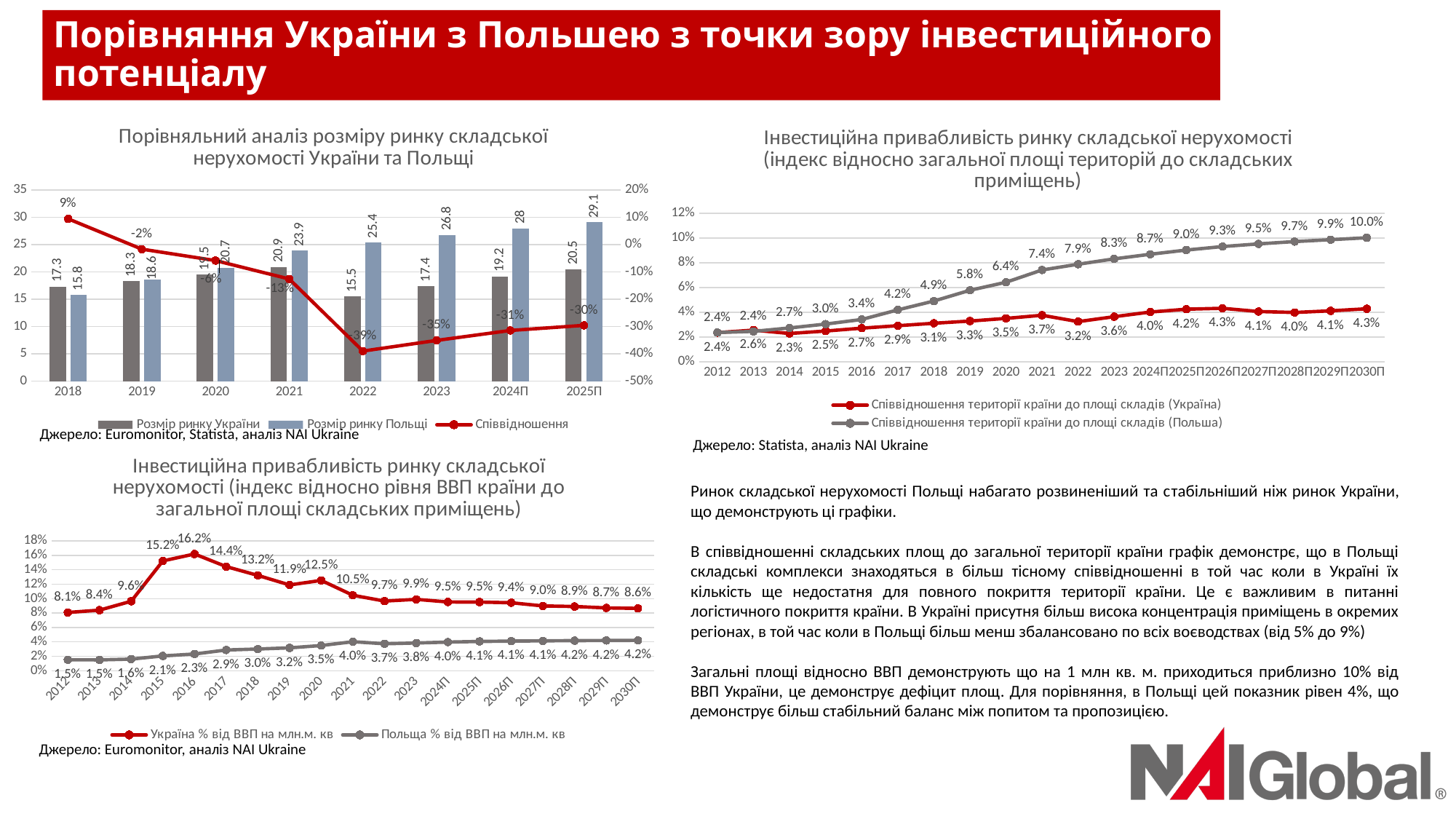
In the top-right chart (Інвестиційна привабливість ринку складської нерухомості, індекс відносно загальної площі територій), what is the value for Польша in 2030П? 10.0% What type of chart is the bottom-left chart (Інвестиційна привабливість ринку складської нерухомості, індекс відносно рівня ВВП)? line chart In the bottom-left chart (Інвестиційна привабливість ринку складської нерухомості, індекс відносно рівня ВВП), in which year is the Україна % від ВВП на млн.м. кв value the highest? 2016 In the top-left chart (Порівняльний аналіз розміру ринку складської нерухомості України та Польщі), what is the Співвідношення value for 2022? -39% In the bottom-left chart (Інвестиційна привабливість ринку складської нерухомості, індекс відносно рівня ВВП), what is the value for Польща % від ВВП на млн.м. кв in 2012? 1.5% In the top-left chart (Порівняльний аналіз розміру ринку складської нерухомості України та Польщі), in which year is Розмір ринку України the lowest? 2022 In the top-right chart (Інвестиційна привабливість ринку складської нерухомості, індекс відносно загальної площі територій), how many years are shown on the x axis? 19 In the top-left chart (Порівняльний аналіз розміру ринку складської нерухомості України та Польщі), how many series does the legend list? 3 In the top-left chart (Порівняльний аналіз розміру ринку складської нерухомості України та Польщі), what is the difference between Розмір ринку Польщі and Розмір ринку України in 2025П? 8.6 In the top-right chart (Інвестиційна привабливість ринку складської нерухомості, індекс відносно загальної площі територій), what is the value for Україна in 2021? 3.7% In the top-left chart (Порівняльний аналіз розміру ринку складської нерухомості України та Польщі), what is the value of Розмір ринку Польщі for 2022? 25.4 In the top-right chart (Інвестиційна привабливість ринку складської нерухомості, індекс відносно загальної площі територій), does the Польша series rise or fall from 2012 to 2030П? rise